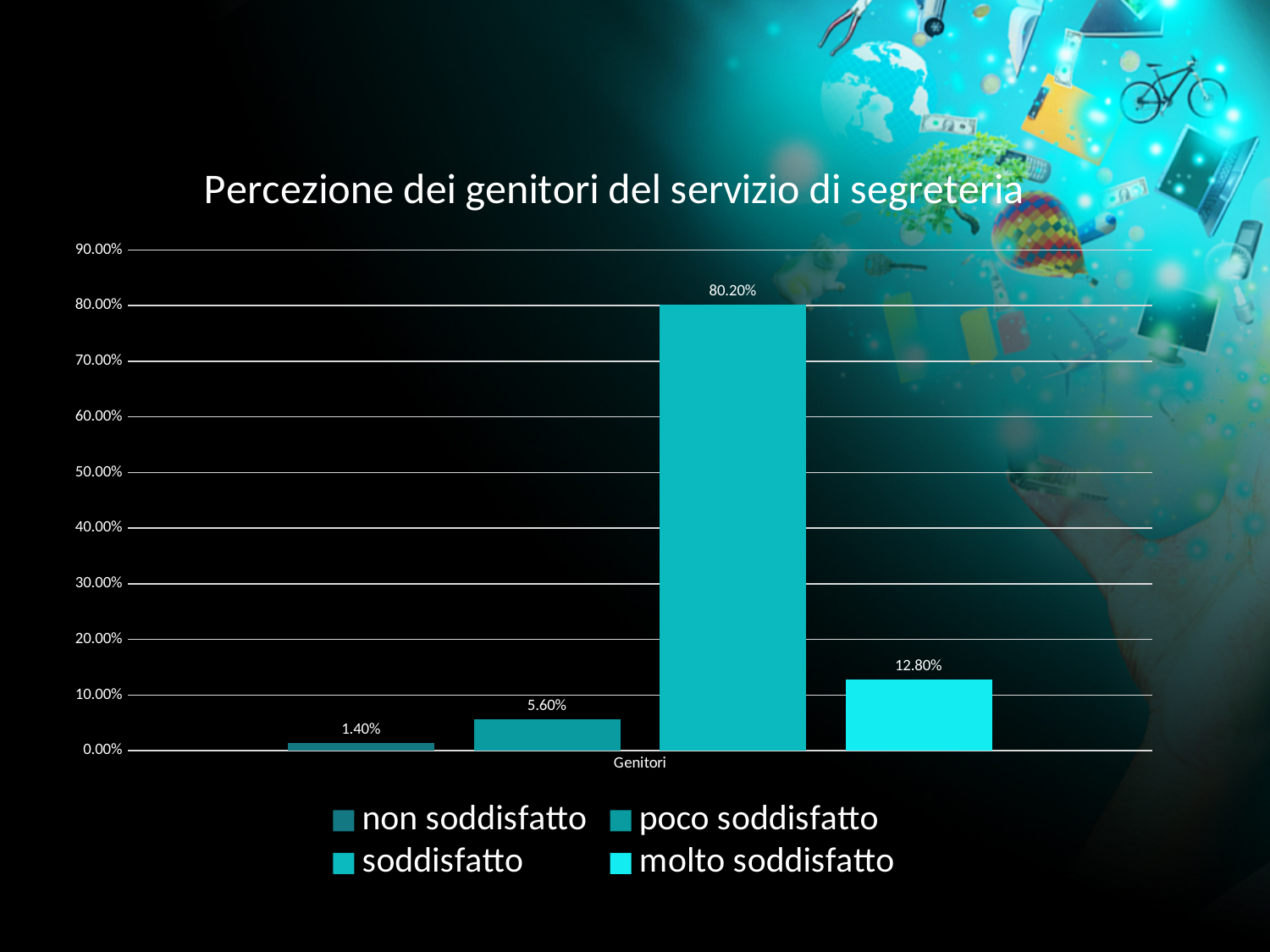
What is the value for "poco soddisfatto"? 5.60% What is the title of the chart? Percezione dei genitori del servizio di segreteria What is the value for "molto soddisfatto"? 12.80% Which is larger, the value for "poco soddisfatto" or the value for "molto soddisfatto"? molto soddisfatto Which series has the highest value? soddisfatto How many series does the legend list? 4 What is the value for "non soddisfatto"? 1.40% What is the difference between the values for "soddisfatto" and "molto soddisfatto"? 67.40% What is the value for "soddisfatto"? 80.20% Which series has the lowest value? non soddisfatto What kind of chart is shown on the slide? bar chart Is the value for "soddisfatto" greater or less than 70.00%? greater